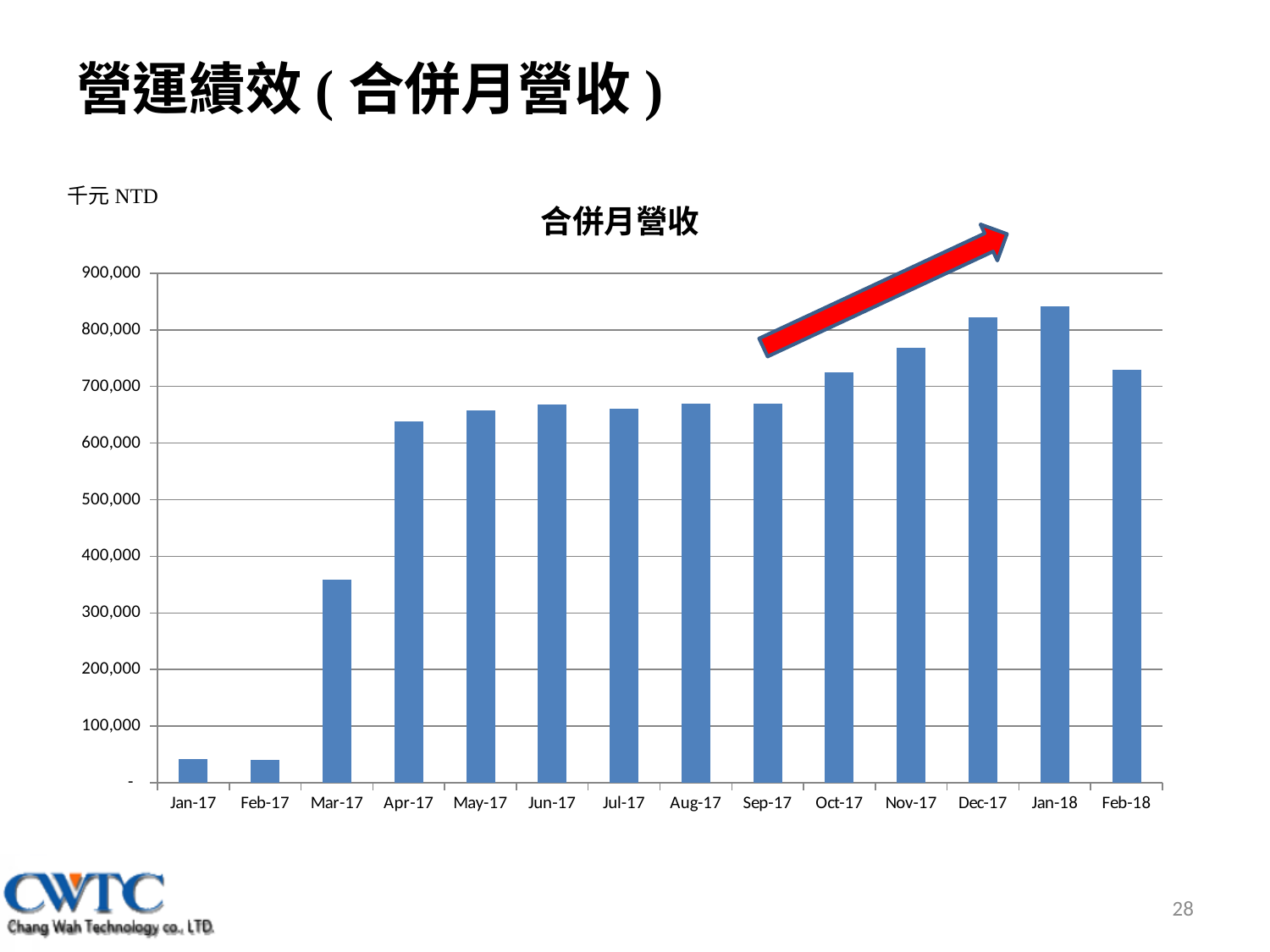
How many months are plotted on the x axis of the chart? 14 Do the values rise or fall from Sep-17 to Jan-18? Rise What unit is stated above the chart for the values? 千元 NTD Which month has the highest bar in the chart? Jan-18 Is the value for Dec-17 greater or less than 800,000? greater Is the value for Jan-17 greater or less than 100,000? less Which is larger, the value for Dec-17 or the value for Feb-18? Dec-17 What kind of chart is shown on the slide? Bar chart Is the value for Mar-17 greater or less than 400,000? less Which is larger, the value for Nov-17 or the value for Oct-17? Nov-17